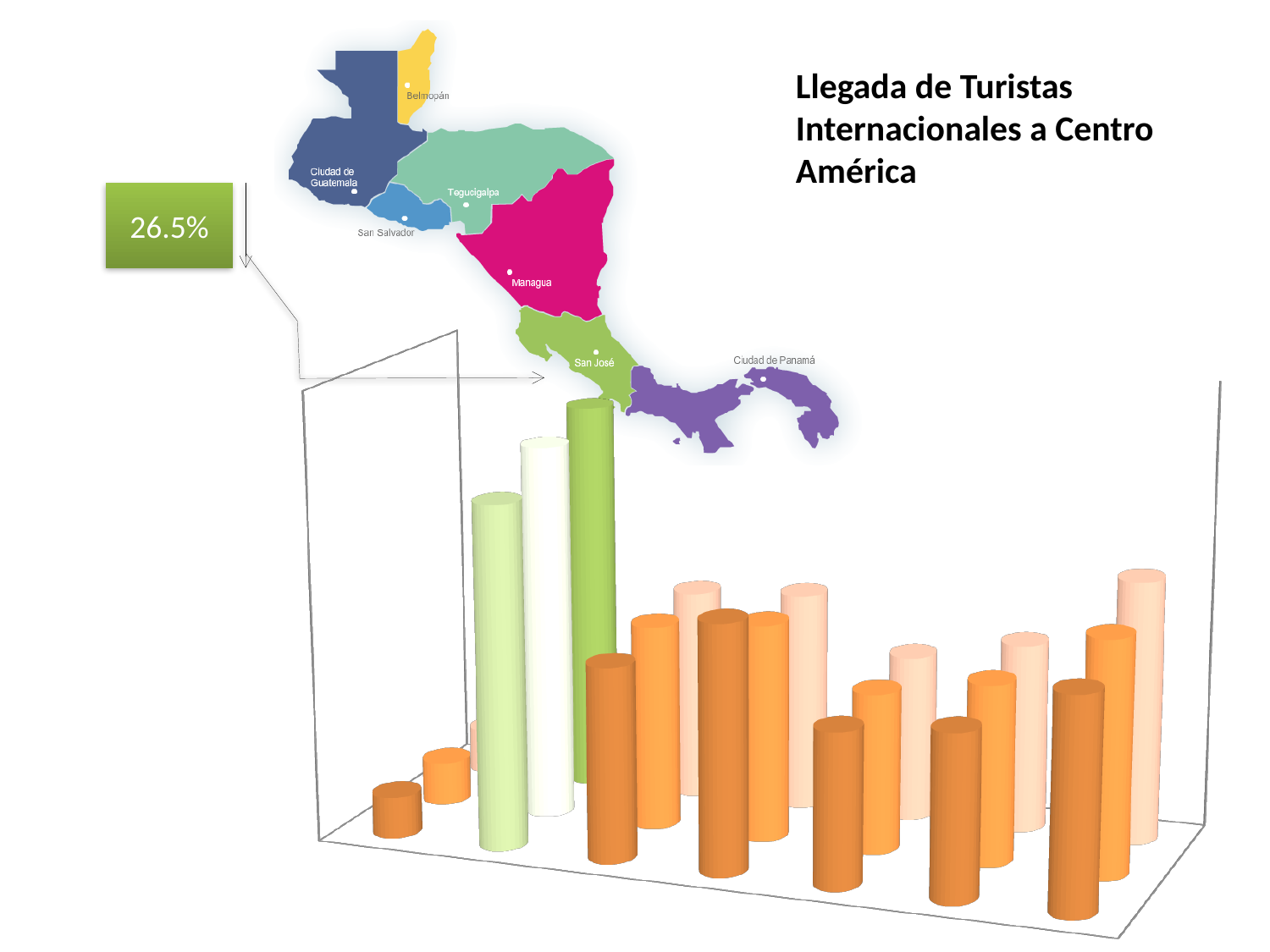
What percentage is shown in the green callout box pointing to the highlighted green bars? 26.5% What is the title shown on the slide for the chart? Llegada de Turistas Internacionales a Centro América What kind of chart is shown on the slide? bar chart